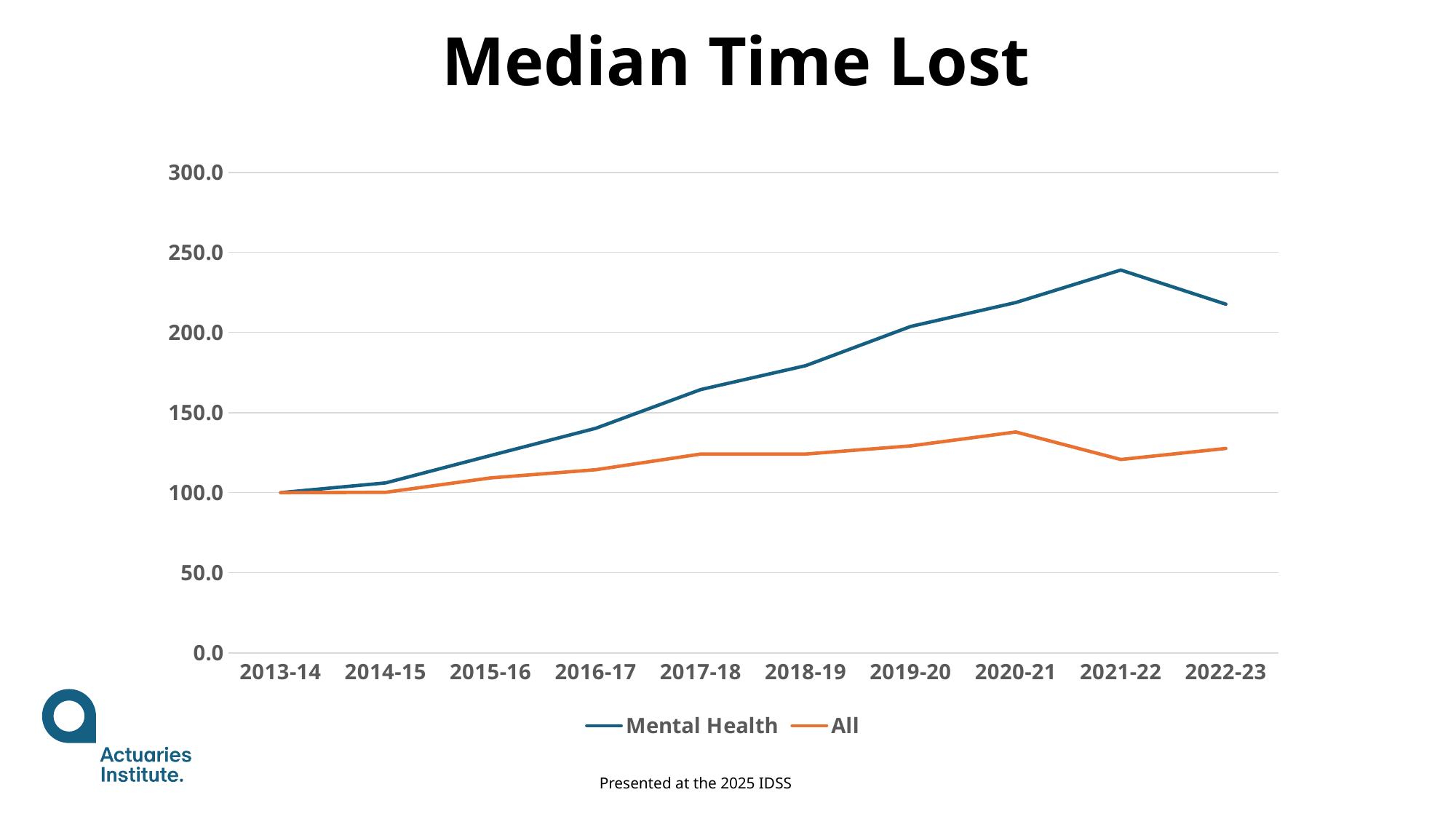
In which year does the All series reach its highest value? 2020-21 In 2022-23, which series has the larger value, Mental Health or All? Mental Health Is the value for All in 2021-22 greater or less than 150.0? less What kind of chart is shown on the slide? line chart In which year does the Mental Health series reach its highest value? 2021-22 How many series does the legend list? 2 Is the value for Mental Health in 2017-18 greater or less than 150.0? greater Which series is drawn in orange? All How many years are plotted along the x axis? 10 In which year is the Mental Health series at its lowest value? 2013-14 Is the value for Mental Health in 2021-22 greater or less than 200.0? greater What is the title of the chart? Median Time Lost